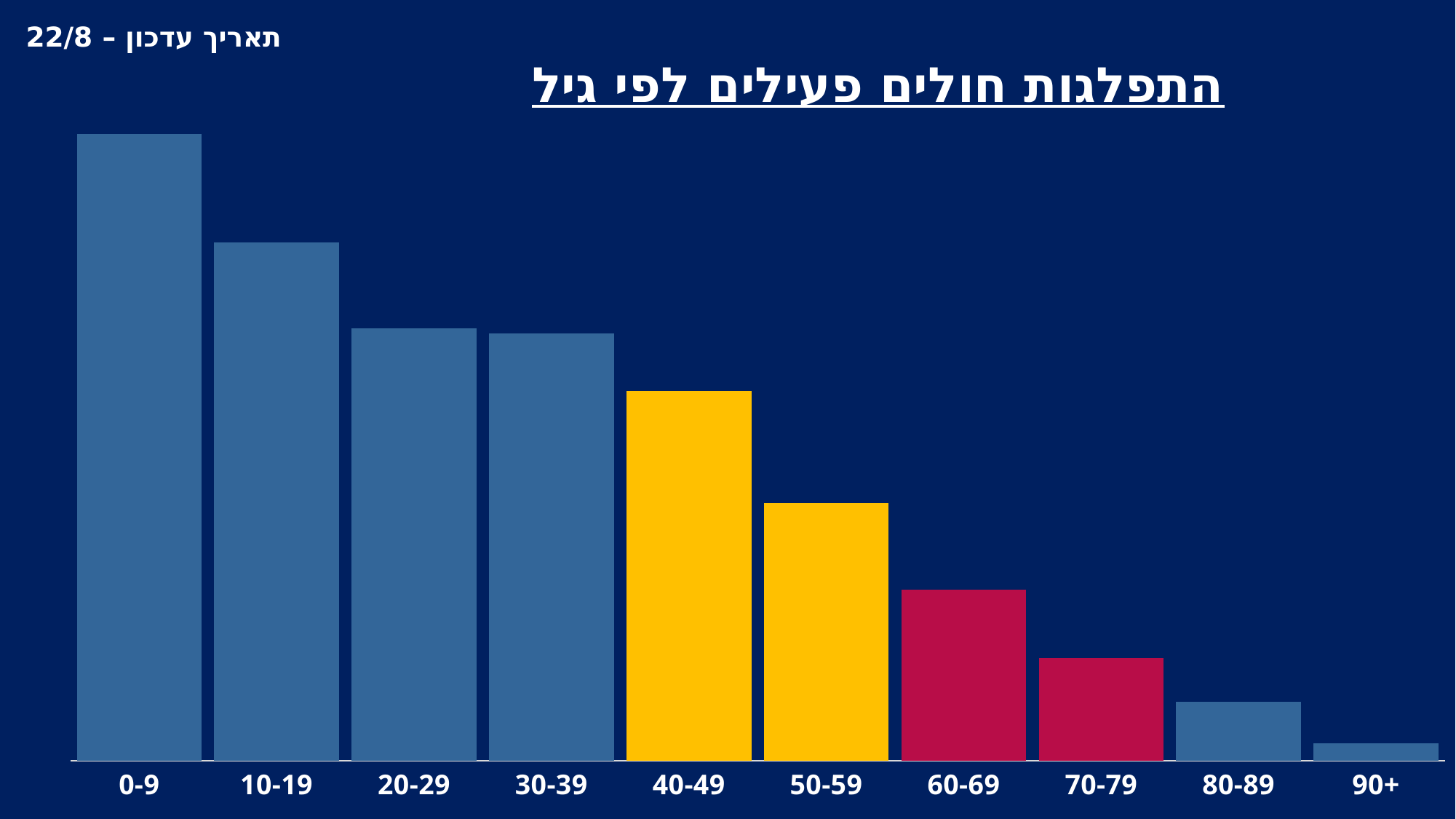
Which is larger, the value for 10-19 or the value for 40-49? 10-19 Do the bar values generally rise or fall as age increases along the x axis? fall How many age categories are shown on the x axis? 10 What kind of chart is shown on the slide? bar chart Which is larger, the value for 70-79 or the value for 80-89? 70-79 Which is larger, the value for 0-9 or the value for 10-19? 0-9 Which age group has the highest bar? 0-9 What is the title of the chart? התפלגות חולים פעילים לפי גיל Which age group has the lowest bar? 90+ Which age groups are shown with yellow bars? 40-49 and 50-59